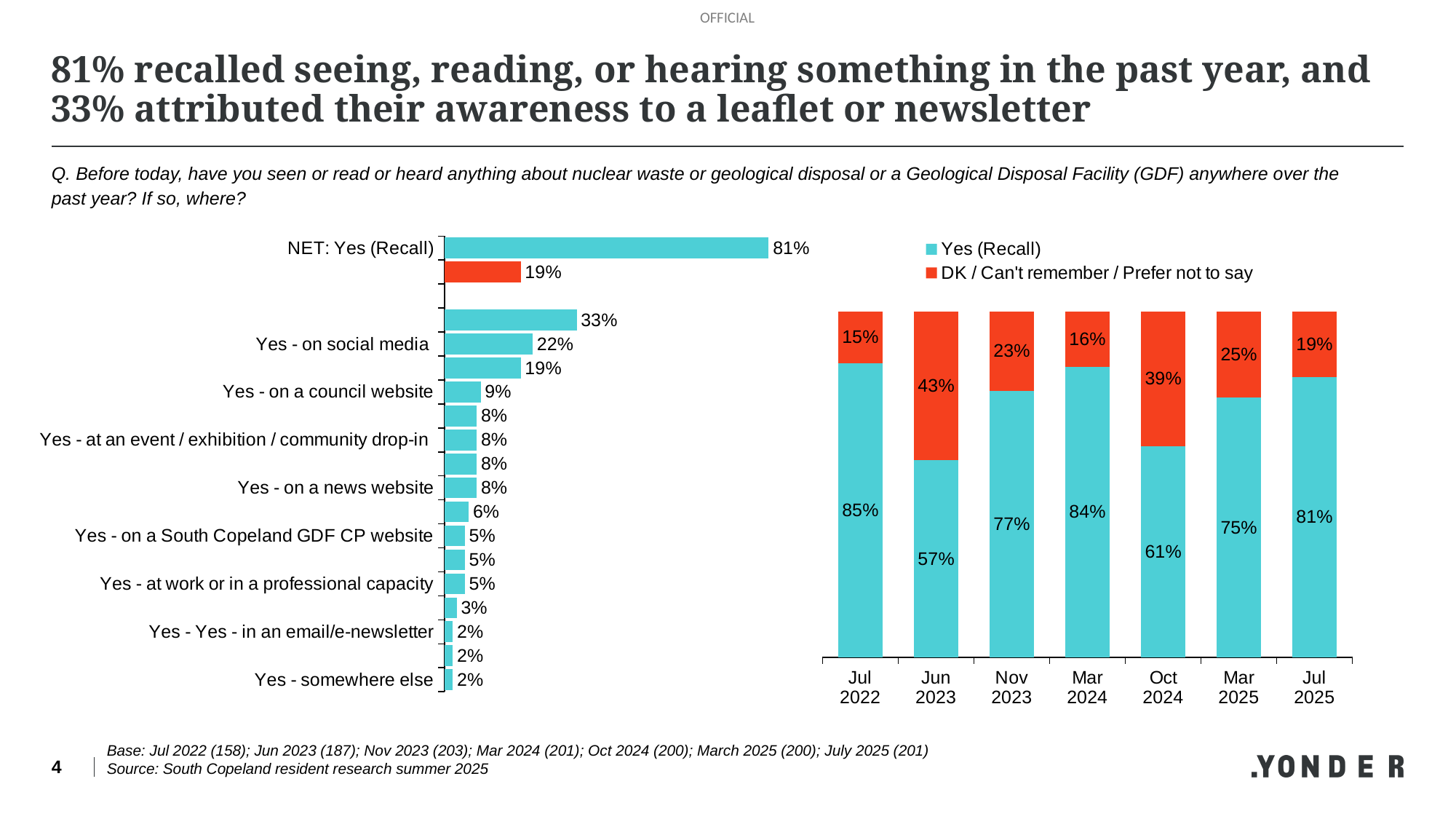
In the right stacked bar chart, what is the total of the Mar 2025 bar? 100% In the right stacked bar chart, what is the 'DK / Can't remember / Prefer not to say' value for Oct 2024? 39% In the right stacked bar chart, which period has the highest 'Yes (Recall)' value? Jul 2022 In the right stacked bar chart, which period has the lowest 'Yes (Recall)' value? Jun 2023 In the right stacked bar chart, how many time periods are shown on the x axis? 7 How many series does the legend of the right stacked bar chart list? 2 In the left bar chart, what is the difference between 'Yes - on social media' and 'Yes - on a news website'? 14 percentage points In the left bar chart, what is the value for 'Yes - on social media'? 22% In the right stacked bar chart, what is the 'Yes (Recall)' value for Jun 2023? 57% In the left bar chart, what is the value for 'NET: Yes (Recall)'? 81% In the left bar chart, which is larger: 'Yes - on a council website' or 'Yes - at work or in a professional capacity'? Yes - on a council website In the left bar chart, what is the value for 'Yes - on a council website'? 9%